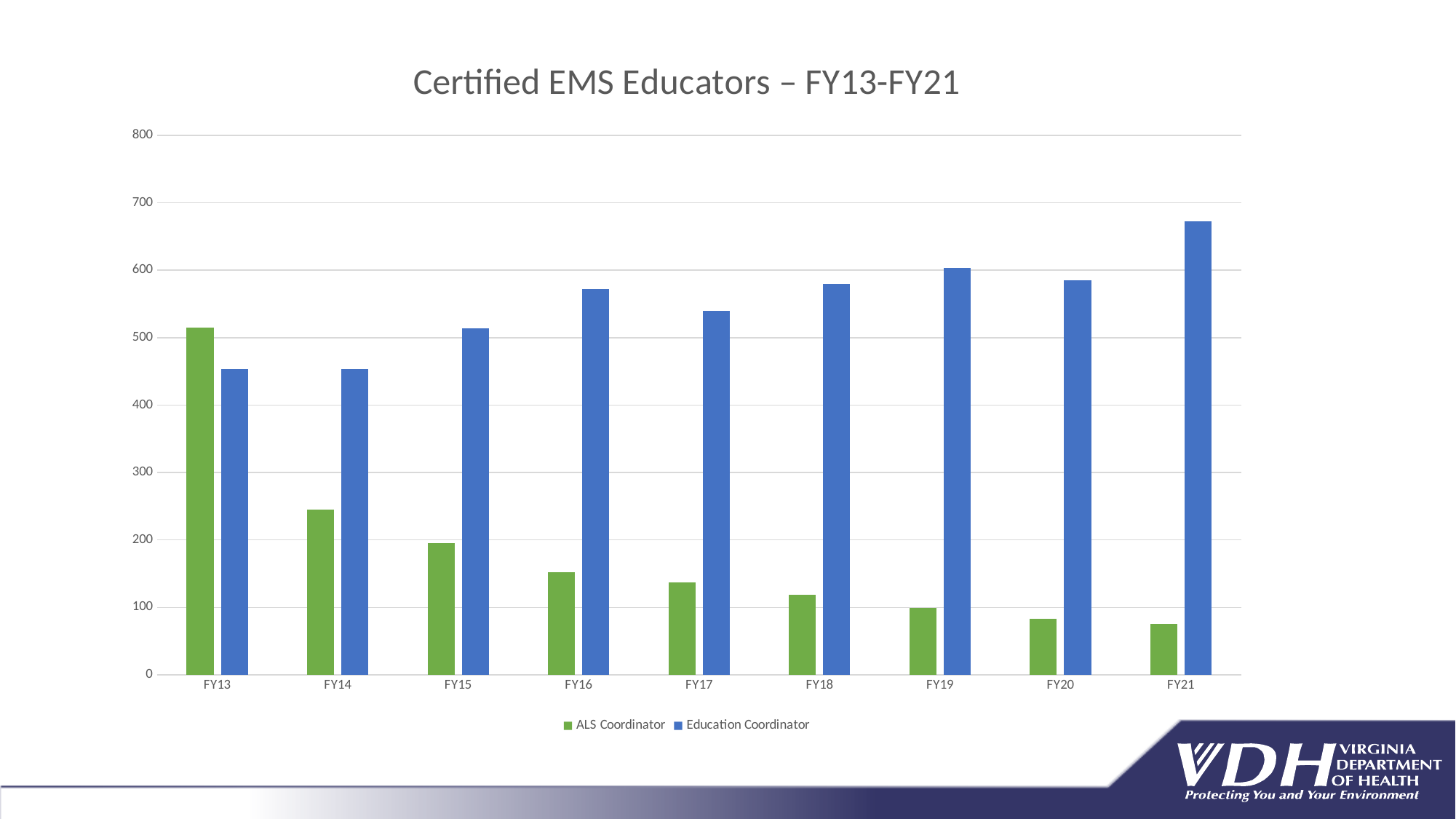
Is the Education Coordinator value for FY21 greater or less than 600? greater In which fiscal year is the Education Coordinator value highest? FY21 What is the title of the chart? Certified EMS Educators – FY13-FY21 What type of chart is shown on the slide? bar chart In which fiscal year is the ALS Coordinator value highest? FY13 How many fiscal years are shown on the x axis? 9 Is the Education Coordinator value for FY13 greater or less than 500? less Does the ALS Coordinator series rise or fall from FY13 to FY21? fall In FY13, which series has the larger value, ALS Coordinator or Education Coordinator? ALS Coordinator Is the ALS Coordinator value for FY21 greater or less than 100? less How many series does the legend list? 2